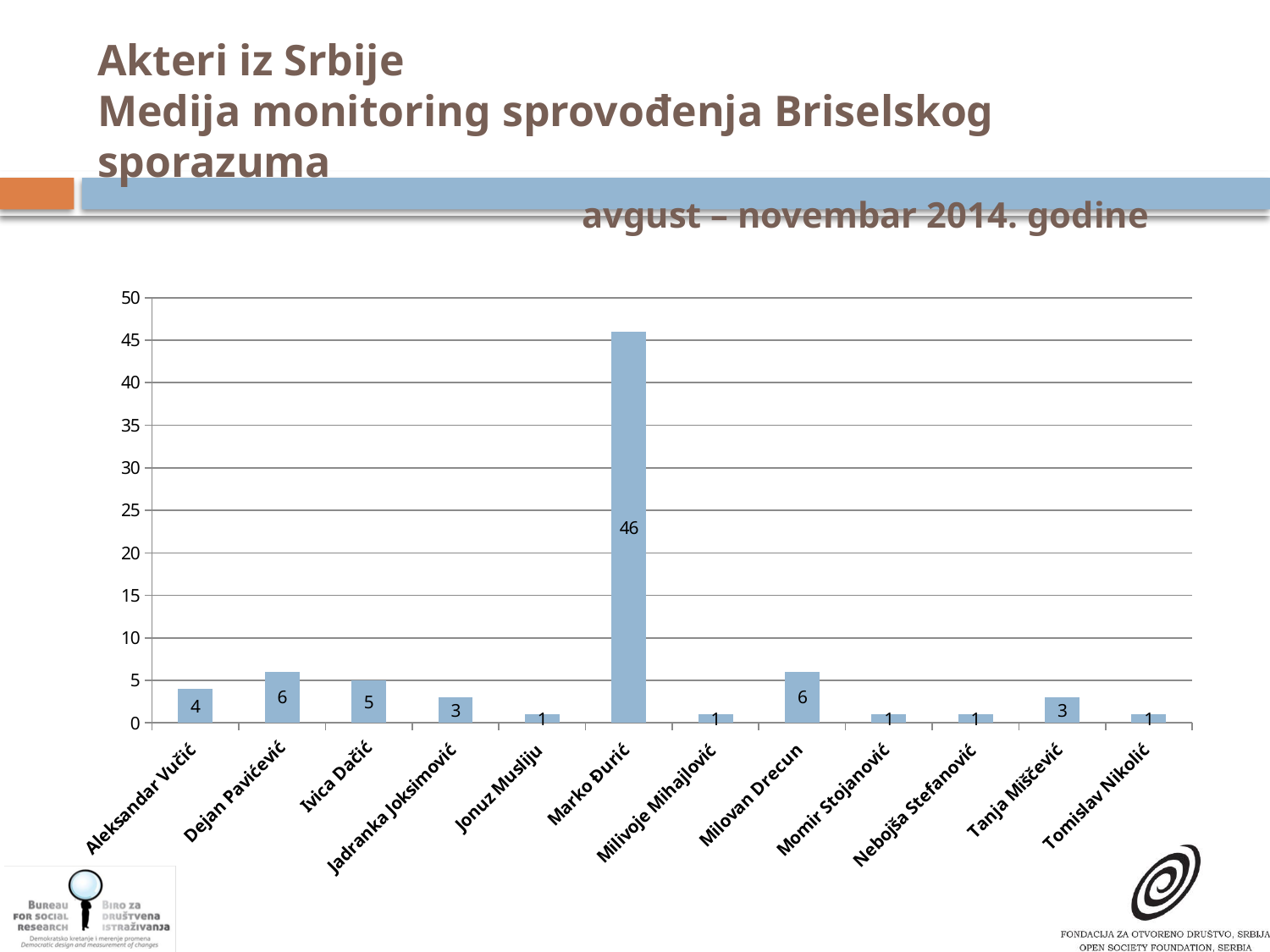
What is the value for Marko Đurić? 46 Which is larger, the value for Dejan Pavićević or the value for Aleksandar Vučić? Dejan Pavićević Which category has the highest value? Marko Đurić What is the value for Tanja Miščević? 3 What is the difference between the values for Ivica Dačić and Jadranka Joksimović? 2 What is the value for Milovan Drecun? 6 Is the value for Marko Đurić greater or less than 40? greater What is the difference between the values for Marko Đurić and Dejan Pavićević? 40 What is the value for Ivica Dačić? 5 What is the value for Aleksandar Vučić? 4 How many categories are shown on the x axis? 12 What kind of chart is shown on the slide? bar chart